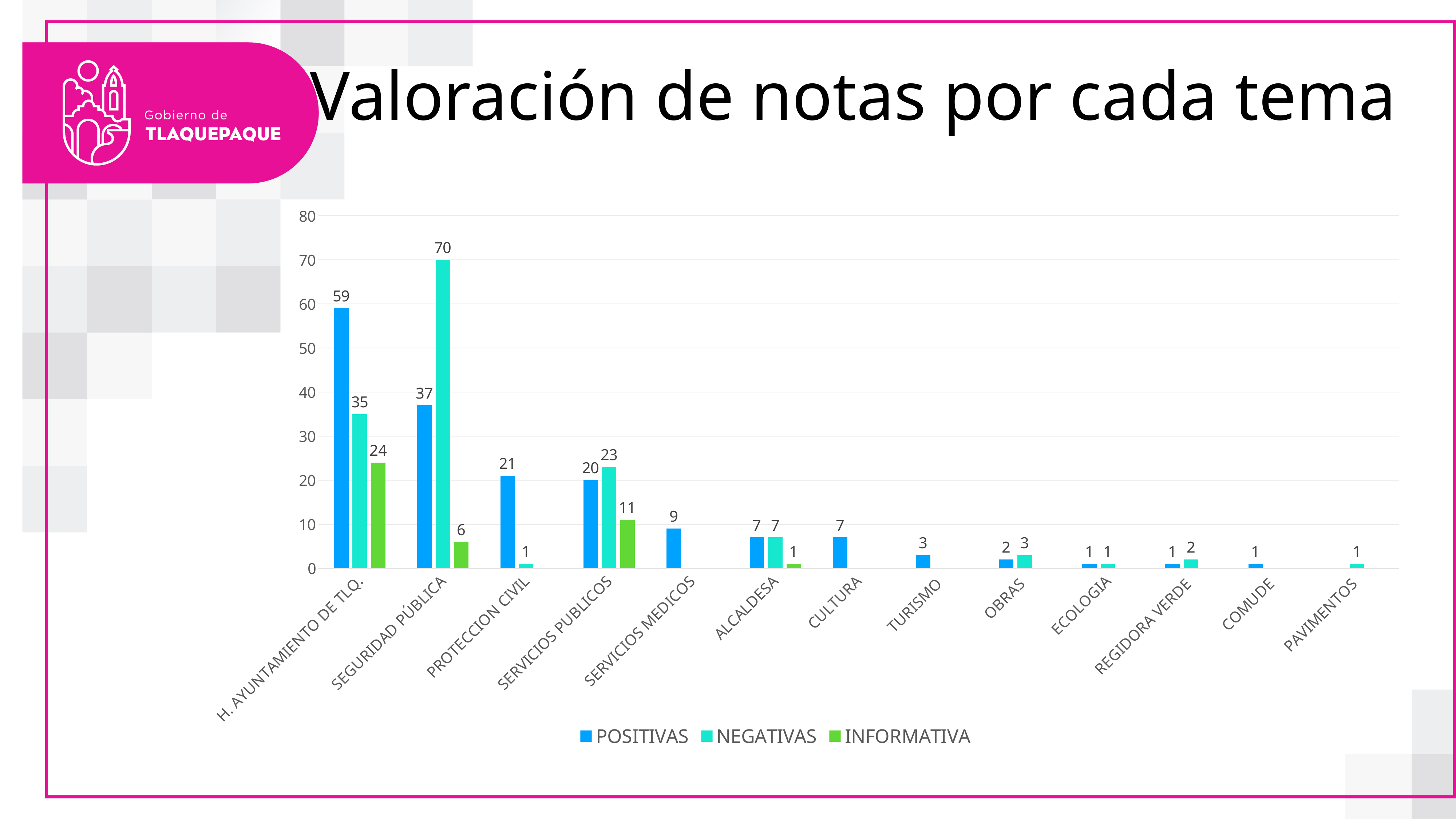
What is the title of the slide? Valoración de notas por cada tema What is the NEGATIVAS value for SEGURIDAD PÚBLICA? 70 How many series does the legend list? 3 What is the POSITIVAS value for H. AYUNTAMIENTO DE TLQ.? 59 What is the difference between the NEGATIVAS and POSITIVAS values for SEGURIDAD PÚBLICA? 33 What is the POSITIVAS value for SERVICIOS MEDICOS? 9 Which category has the highest NEGATIVAS value? SEGURIDAD PÚBLICA What kind of chart is shown on the slide? Bar chart Which is larger for SERVICIOS PUBLICOS, the POSITIVAS value or the NEGATIVAS value? NEGATIVAS What is the INFORMATIVA value for SERVICIOS PUBLICOS? 11 How many categories are shown on the x axis? 13 Which category has the highest POSITIVAS value? H. AYUNTAMIENTO DE TLQ.